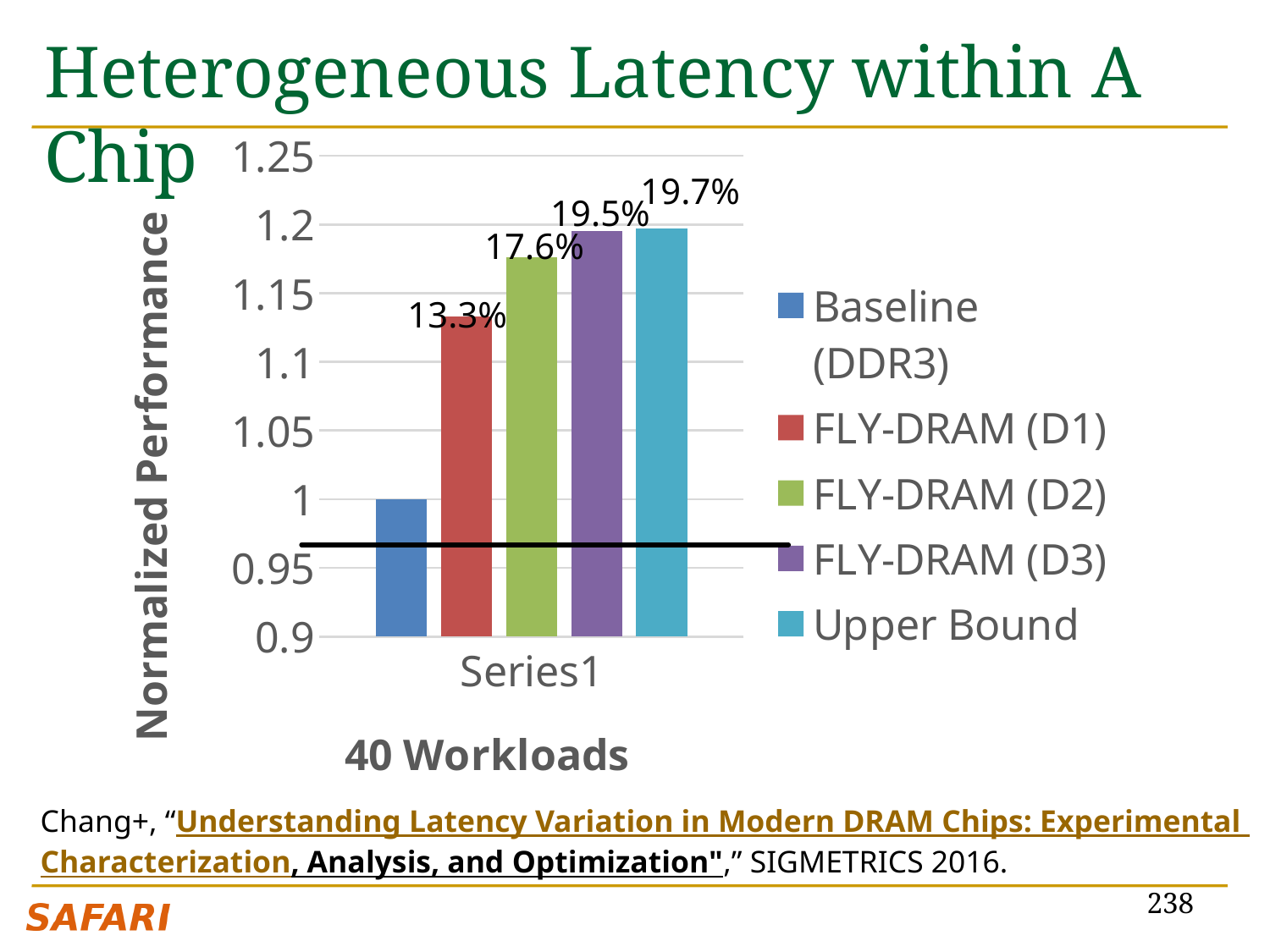
What data label is printed above the FLY-DRAM (D2) bar? 17.6% What is the title of the vertical axis? Normalized Performance What data label is printed above the Upper Bound bar? 19.7% How many series does the legend list? 5 Which bar is taller, FLY-DRAM (D2) or FLY-DRAM (D1)? FLY-DRAM (D2) Is the normalized performance for FLY-DRAM (D2) greater or less than 1.15? greater What is the difference between the percentage labels of Upper Bound and FLY-DRAM (D1)? 6.4% What data label is printed above the FLY-DRAM (D1) bar? 13.3% Which series has the shortest bar? Baseline (DDR3) What normalized performance value does the Baseline (DDR3) bar reach? 1 What data label is printed above the FLY-DRAM (D3) bar? 19.5% Which series has the tallest bar? Upper Bound